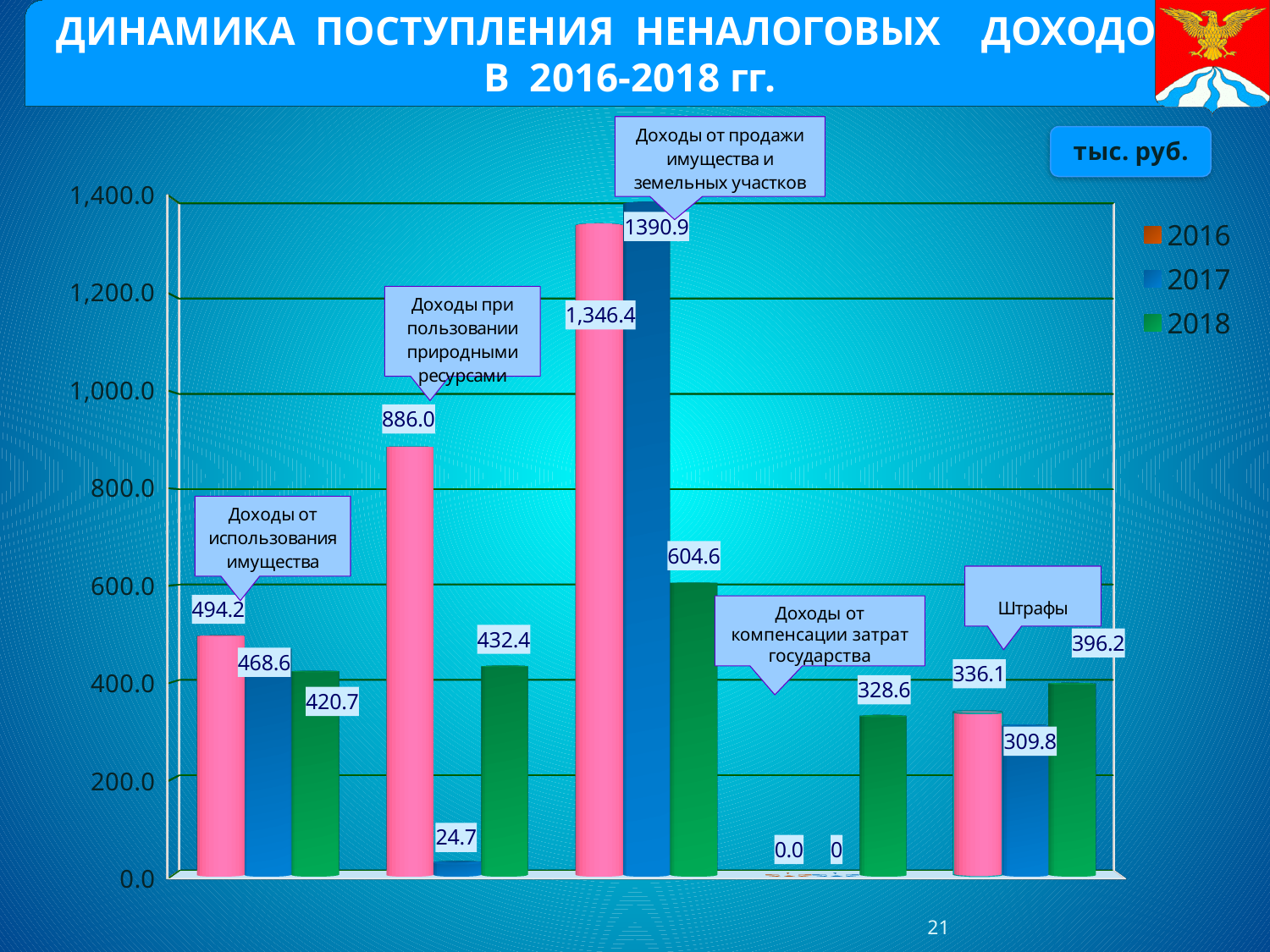
Do the values for Доходы от использования имущества rise or fall from 2016 to 2018? fall How many categories are shown on the chart? 5 Which is larger for Доходы от продажи имущества и земельных участков: the 2016 value or the 2017 value? 2017 What is the difference between the 2016 and 2018 values for Доходы при пользовании природными ресурсами? 453.6 What is the 2017 value for Доходы при пользовании природными ресурсами? 24.7 What unit is indicated in the box at the top right of the chart? тыс. руб. What is the 2018 value for Штрафы? 396.2 How many series does the legend list? 3 Which category has the lowest 2018 value? Доходы от компенсации затрат государства Which category has the highest 2017 value? Доходы от продажи имущества и земельных участков What is the 2016 value for Доходы от использования имущества? 494.2 What kind of chart is shown on the slide? bar chart